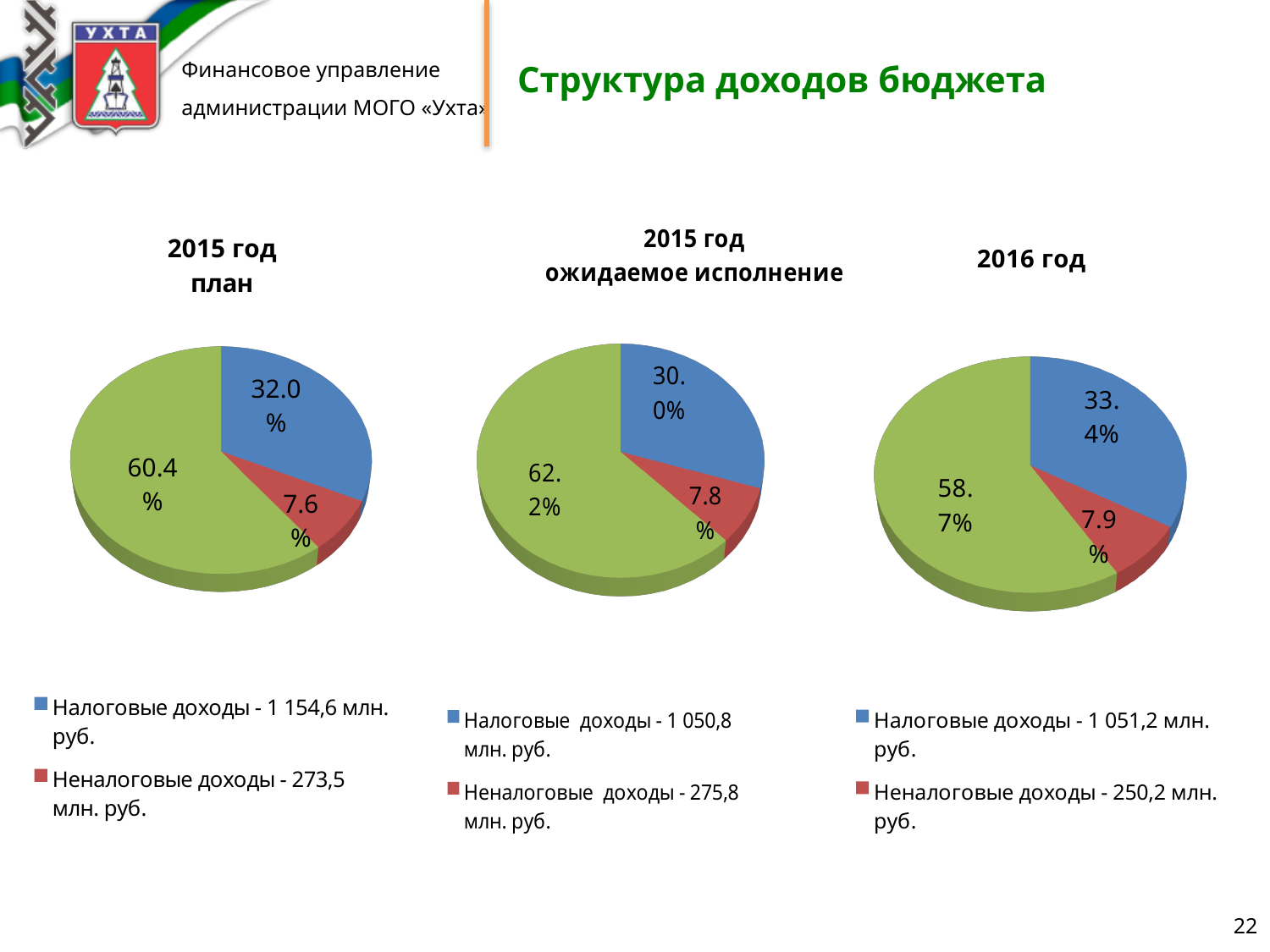
According to the legend under the "2016 год" pie chart, what amount is given for Налоговые доходы? 1 051,2 млн. руб. In the "2016 год" pie chart, which labelled category has the smallest slice? Неналоговые доходы How many slices does the "2015 год план" pie chart have? 3 In the "2015 год план" pie chart, what percentage is shown for Налоговые доходы? 32.0% Is the share of Налоговые доходы larger in the "2015 год план" chart or in the "2016 год" chart? 2016 год In the "2015 год ожидаемое исполнение" pie chart, what percentage is shown for Налоговые доходы? 30.0% How many entries does the legend under the "2016 год" pie chart list? 2 In the "2015 год план" pie chart, what percentage is shown on the largest slice? 60.4% In the "2016 год" pie chart, what percentage is shown for Неналоговые доходы? 7.9% What kind of chart is used for "2016 год"? Pie chart In the "2015 год план" pie chart, what is the difference in percentage points between Налоговые доходы and Неналоговые доходы? 24.4 In the "2015 год ожидаемое исполнение" pie chart, what percentage is shown for Неналоговые доходы? 7.8%